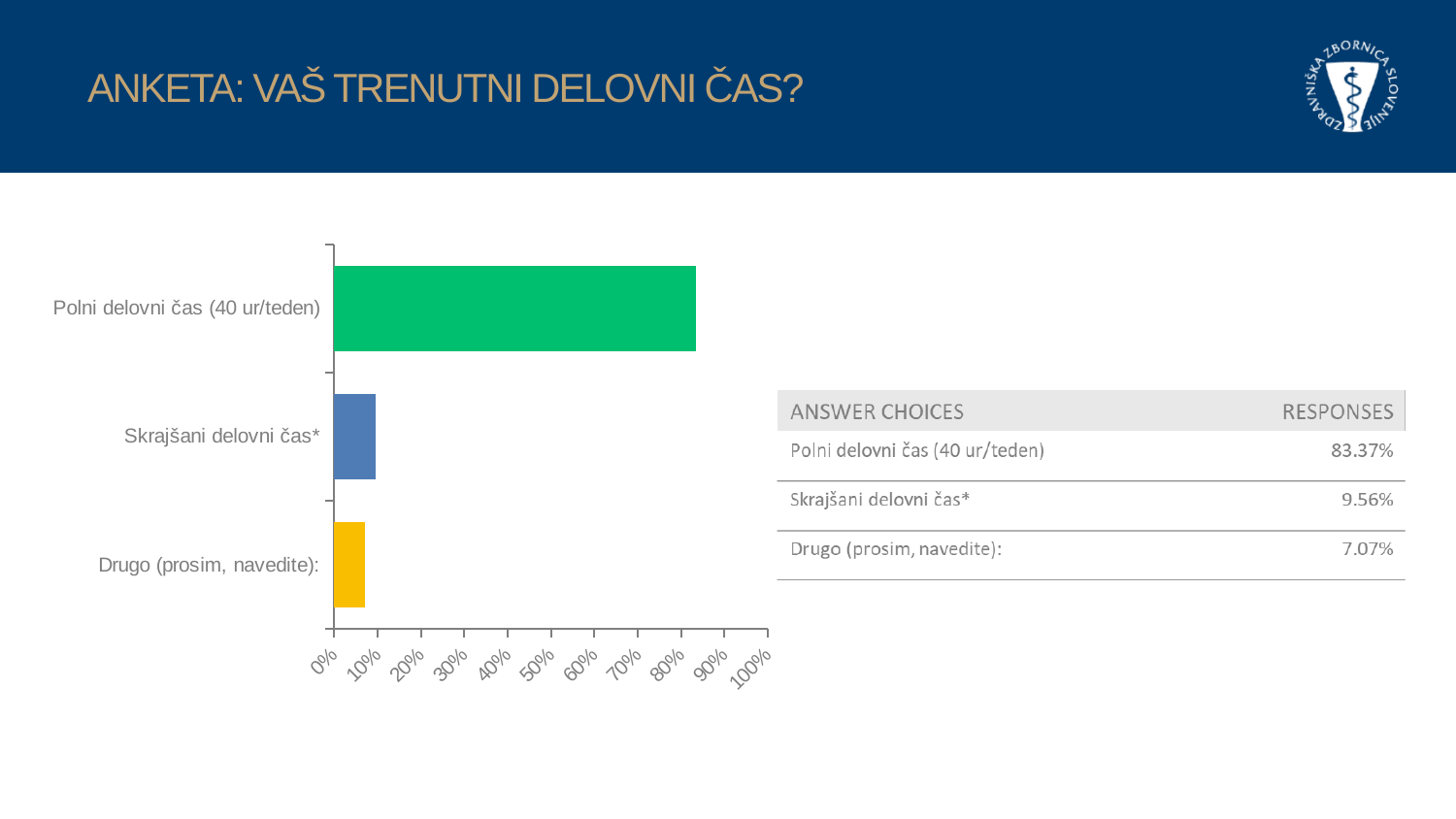
What is the difference between the values for Polni delovni čas (40 ur/teden) and Skrajšani delovni čas*? 73.81% Which category has the highest value? Polni delovni čas (40 ur/teden) What is the value for Polni delovni čas (40 ur/teden)? 83.37% What is the difference between the values for Skrajšani delovni čas* and Drugo (prosim, navedite):? 2.49% What kind of chart is shown on the slide? Bar chart Which category has the lowest value? Drugo (prosim, navedite): How many categories are shown in the chart? 3 What is the value for Drugo (prosim, navedite):? 7.07% Which is larger, the value for Skrajšani delovni čas* or the value for Drugo (prosim, navedite):? Skrajšani delovni čas* Is the value for Skrajšani delovni čas* greater or less than 20%? less What is the value for Skrajšani delovni čas*? 9.56% Is the value for Polni delovni čas (40 ur/teden) greater or less than 80%? greater